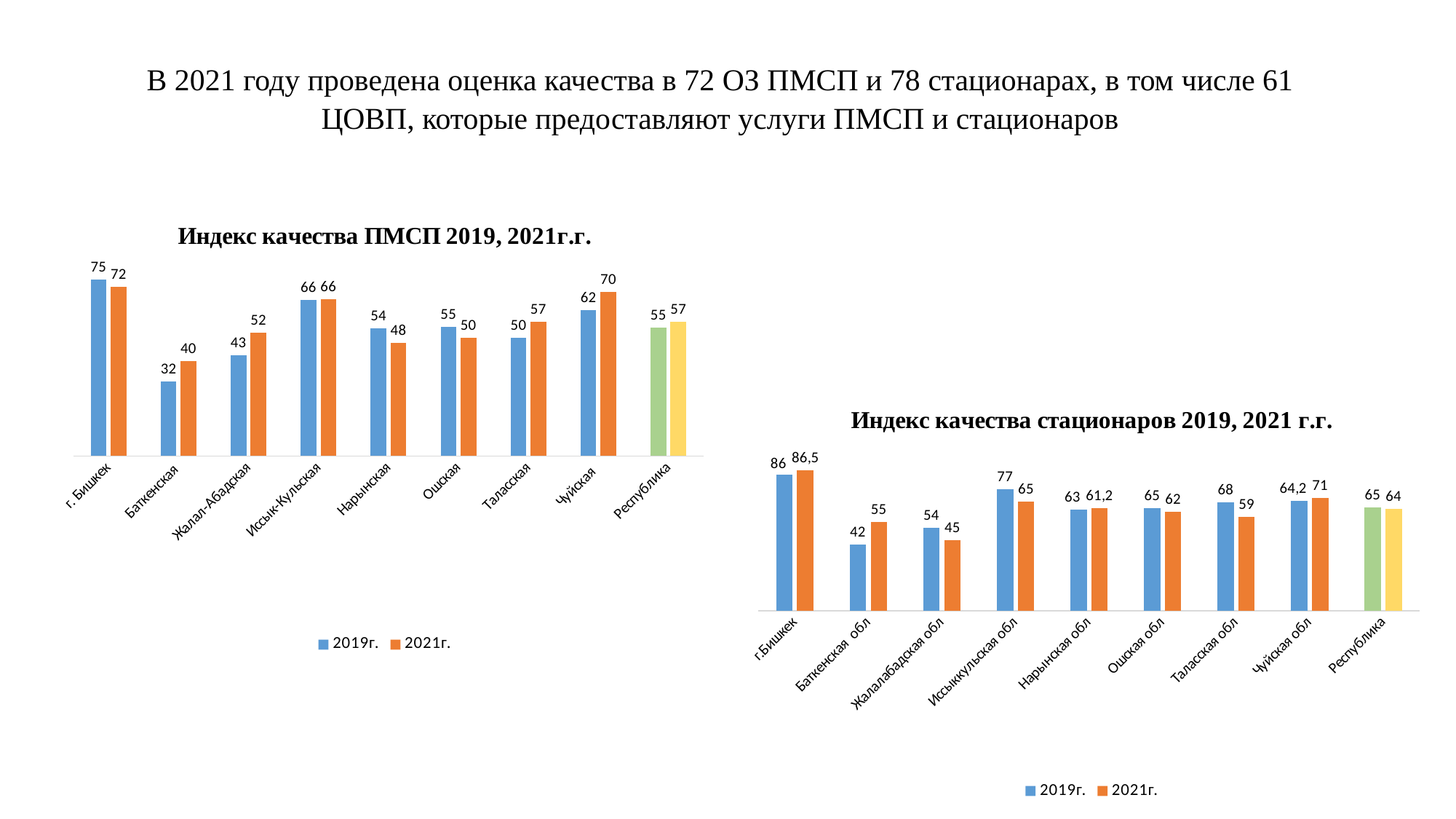
In the chart 'Индекс качества стационаров 2019, 2021 г.г.', what is the difference between the 2019г. and 2021г. values for Иссыккульская обл? 12 In the chart 'Индекс качества стационаров 2019, 2021 г.г.', what is the value for Чуйская обл in 2019г.? 64,2 In the chart 'Индекс качества ПМСП 2019, 2021г.г.', which category has the highest 2019г. value? г. Бишкек In the chart 'Индекс качества стационаров 2019, 2021 г.г.', which is larger for Таласская обл: the 2019г. value or the 2021г. value? 2019г. How many series does the legend of the chart 'Индекс качества стационаров 2019, 2021 г.г.' list? 2 In the chart 'Индекс качества ПМСП 2019, 2021г.г.', what is the difference between the 2021г. and 2019г. values for Жалал-Абадская? 9 In the chart 'Индекс качества ПМСП 2019, 2021г.г.', which category has the lowest 2021г. value? Баткенская In the chart 'Индекс качества ПМСП 2019, 2021г.г.', what is the value for Баткенская in 2019г.? 32 In the chart 'Индекс качества стационаров 2019, 2021 г.г.', what is the value for г.Бишкек in 2021г.? 86,5 In the chart 'Индекс качества ПМСП 2019, 2021г.г.', how many categories are shown on the x axis? 9 In the chart 'Индекс качества стационаров 2019, 2021 г.г.', which category has the lowest 2019г. value? Баткенская обл In the chart 'Индекс качества ПМСП 2019, 2021г.г.', what is the value for Чуйская in 2021г.? 70